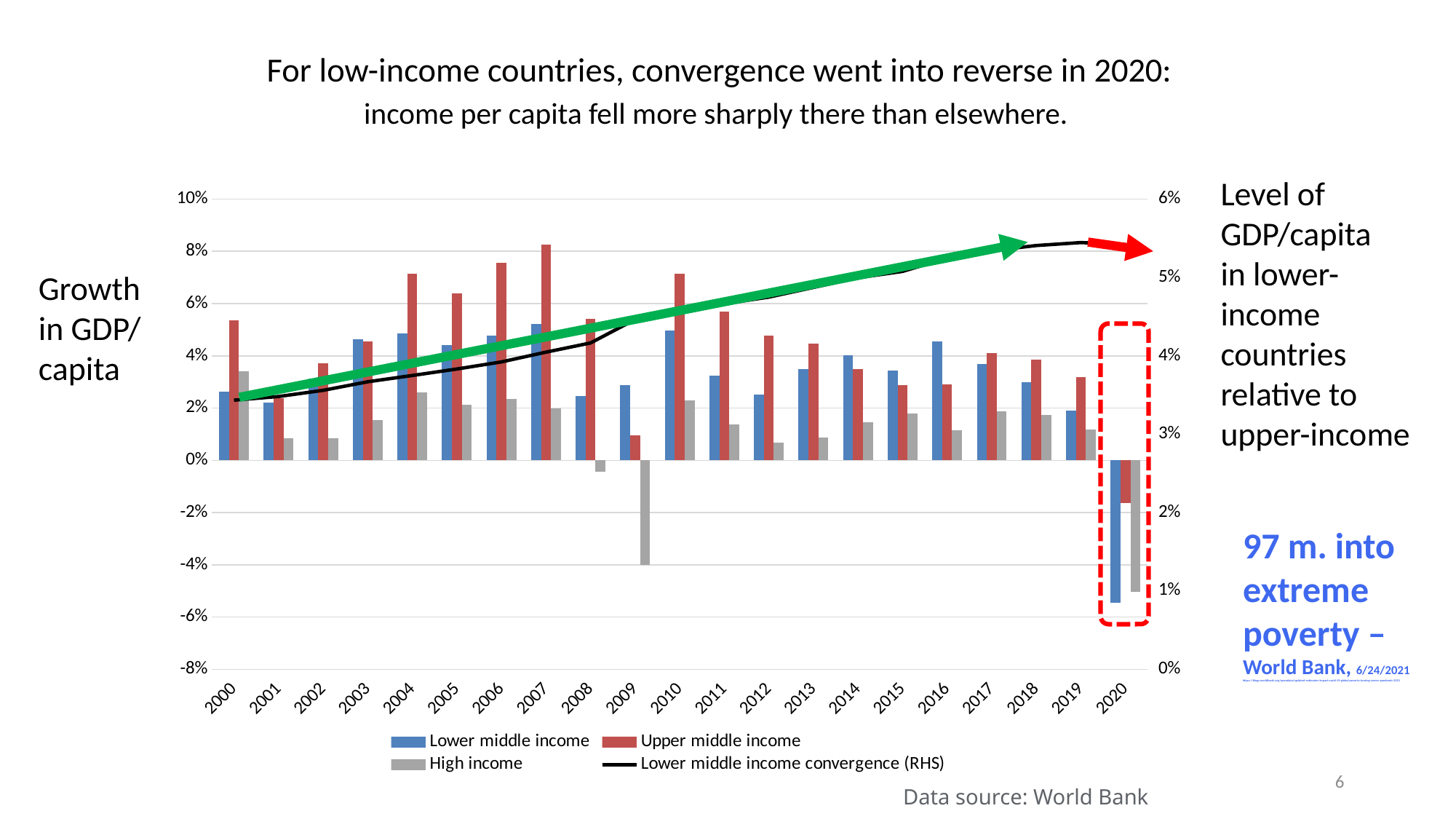
In which year is the Upper middle income growth bar the highest? 2007 What kind of chart is shown on the slide? bar chart (with a line series) Is the Upper middle income value for 2007 greater or less than 6%? greater Does the Lower middle income convergence (RHS) line rise or fall from 2000 to 2019? rise Is the Lower middle income value for 2020 greater or less than -4%? less How many series does the legend list? 4 In which year is the Lower middle income growth bar the lowest? 2020 In which year is the High income growth bar the lowest? 2020 In 2010, which is larger: the Lower middle income bar or the Upper middle income bar? Upper middle income How many years are shown on the x axis? 21 Is the High income value for 2009 greater or less than -2%? less In 2016, which is larger: the Lower middle income bar or the Upper middle income bar? Lower middle income